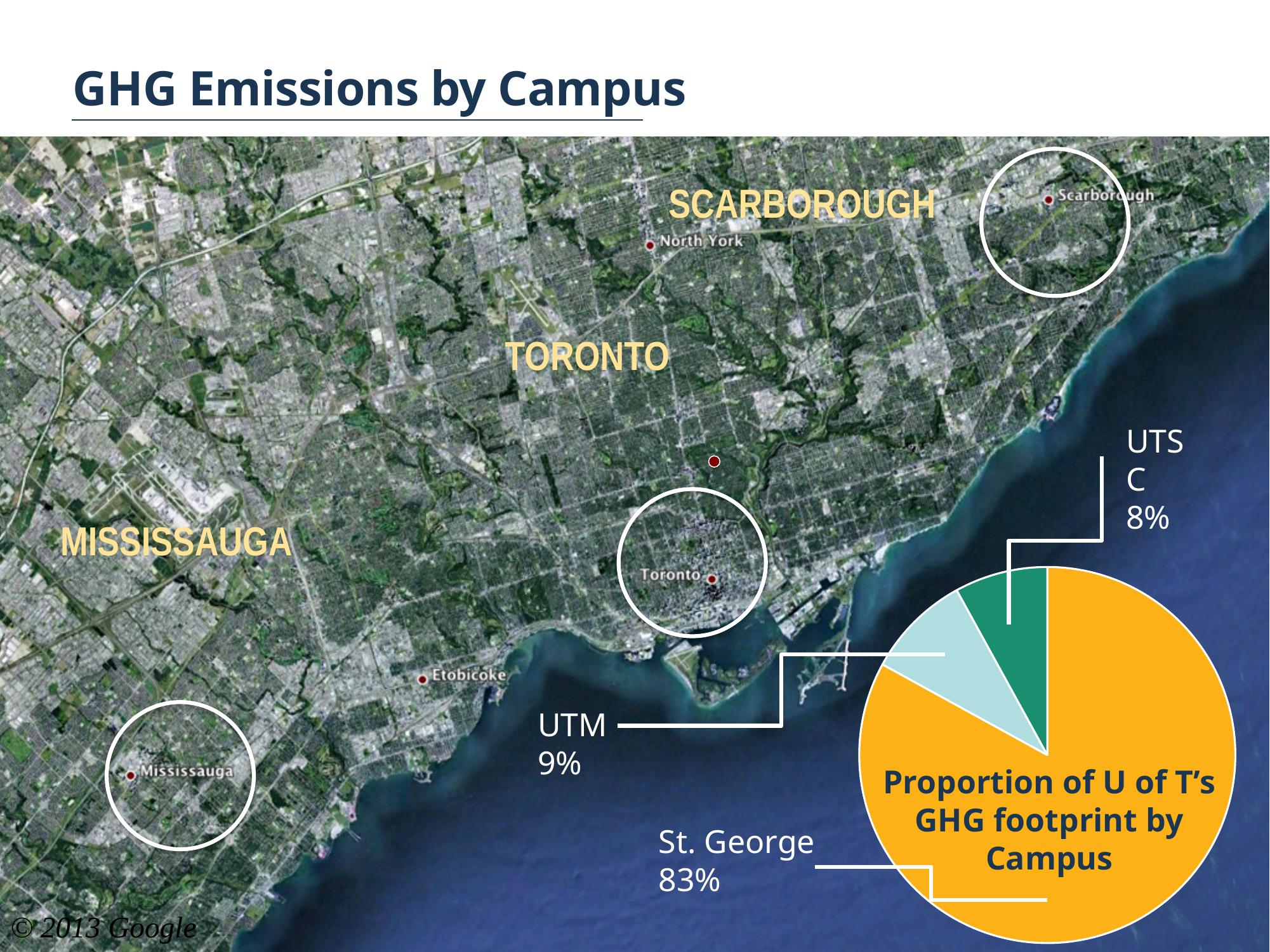
What is the title printed on the pie chart? Proportion of U of T's GHG footprint by Campus What share of U of T's GHG footprint does the St. George campus account for? 83% Which campus has the smallest share of U of T's GHG footprint? UTSC What is the difference in percentage points between the UTM share and the UTSC share? 1 How many campuses are shown as slices in the pie chart? 3 What kind of chart is used to show the proportion of U of T's GHG footprint by campus? Pie chart What share of U of T's GHG footprint does UTSC account for? 8% What is the difference in percentage points between the St. George share and the UTM share? 74 Which campus has a larger share of the GHG footprint, UTM or UTSC? UTM Which campus has the largest share of U of T's GHG footprint? St. George What share of U of T's GHG footprint does UTM account for? 9% What colour is the St. George slice of the pie chart? Orange